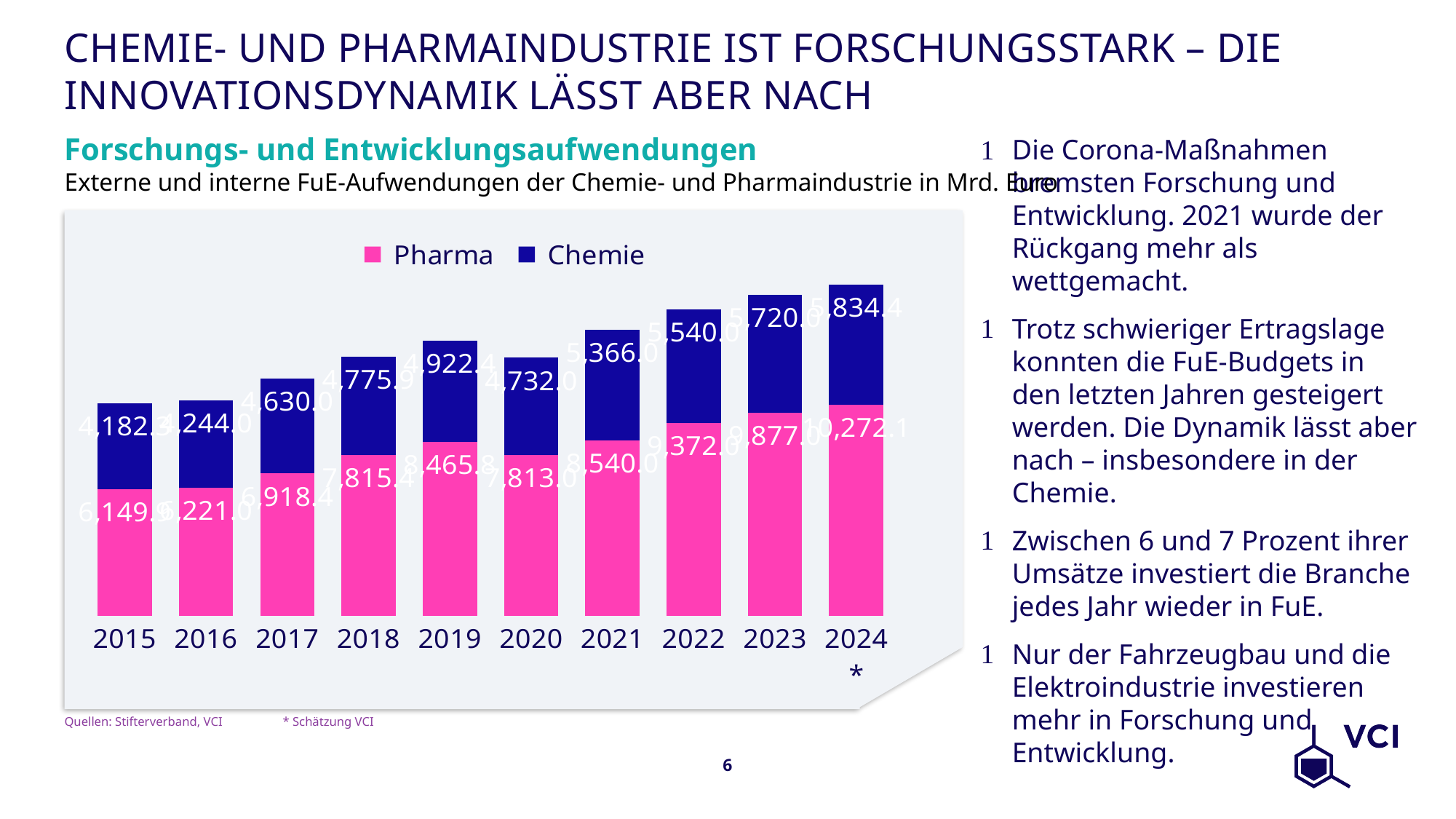
How many years are shown on the x axis? 10 In which year is the Chemie value lowest? 2015 What is the difference between the Chemie values for 2024 and 2023? 114.4 What kind of chart is shown? Stacked bar chart Which is larger, the Pharma value for 2019 or for 2020? 2019 In which year is the Pharma value highest? 2024 Which colour represents Pharma in the legend? Pink What is the total of the stacked bar for 2024? 16,106.5 What is the Chemie value for 2021? 5,366.0 How many series does the legend list? 2 What is the Pharma value for 2024? 10,272.1 What is the Pharma value for 2020? 7,813.0